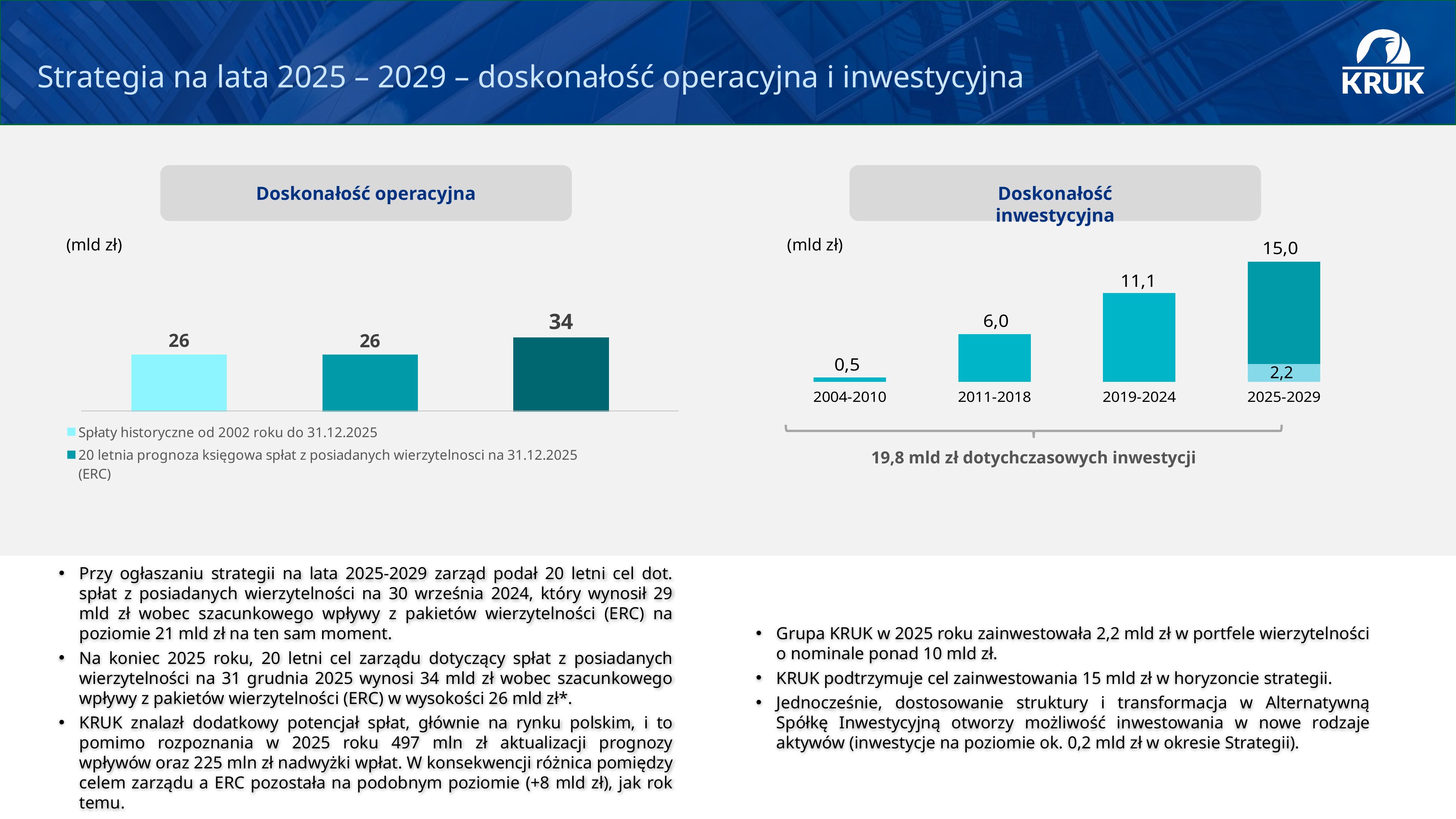
In the 'Doskonałość inwestycyjna' chart, which period has the highest value? 2025-2029 In the 'Doskonałość inwestycyjna' chart, what is the value for 2019-2024? 11,1 How many entries does the legend of the 'Doskonałość operacyjna' chart list? 2 In the 'Doskonałość operacyjna' chart, what is the value of the tallest bar? 34 In the 'Doskonałość operacyjna' chart, what is the value for 'Spłaty historyczne od 2002 roku do 31.12.2025'? 26 In the 'Doskonałość inwestycyjna' chart, which period has the lowest value? 2004-2010 In the 'Doskonałość inwestycyjna' chart, do the values rise or fall from 2004-2010 to 2025-2029? rise In the 'Doskonałość inwestycyjna' chart, what is the difference between the values for 2019-2024 and 2011-2018? 5,1 In the 'Doskonałość inwestycyjna' chart, what is the value for 2004-2010? 0,5 In the 'Doskonałość inwestycyjna' chart, what is the value of the lighter lower segment of the 2025-2029 bar? 2,2 What kind of chart is the 'Doskonałość inwestycyjna' chart? bar chart How many periods are shown on the x axis of the 'Doskonałość inwestycyjna' chart? 4